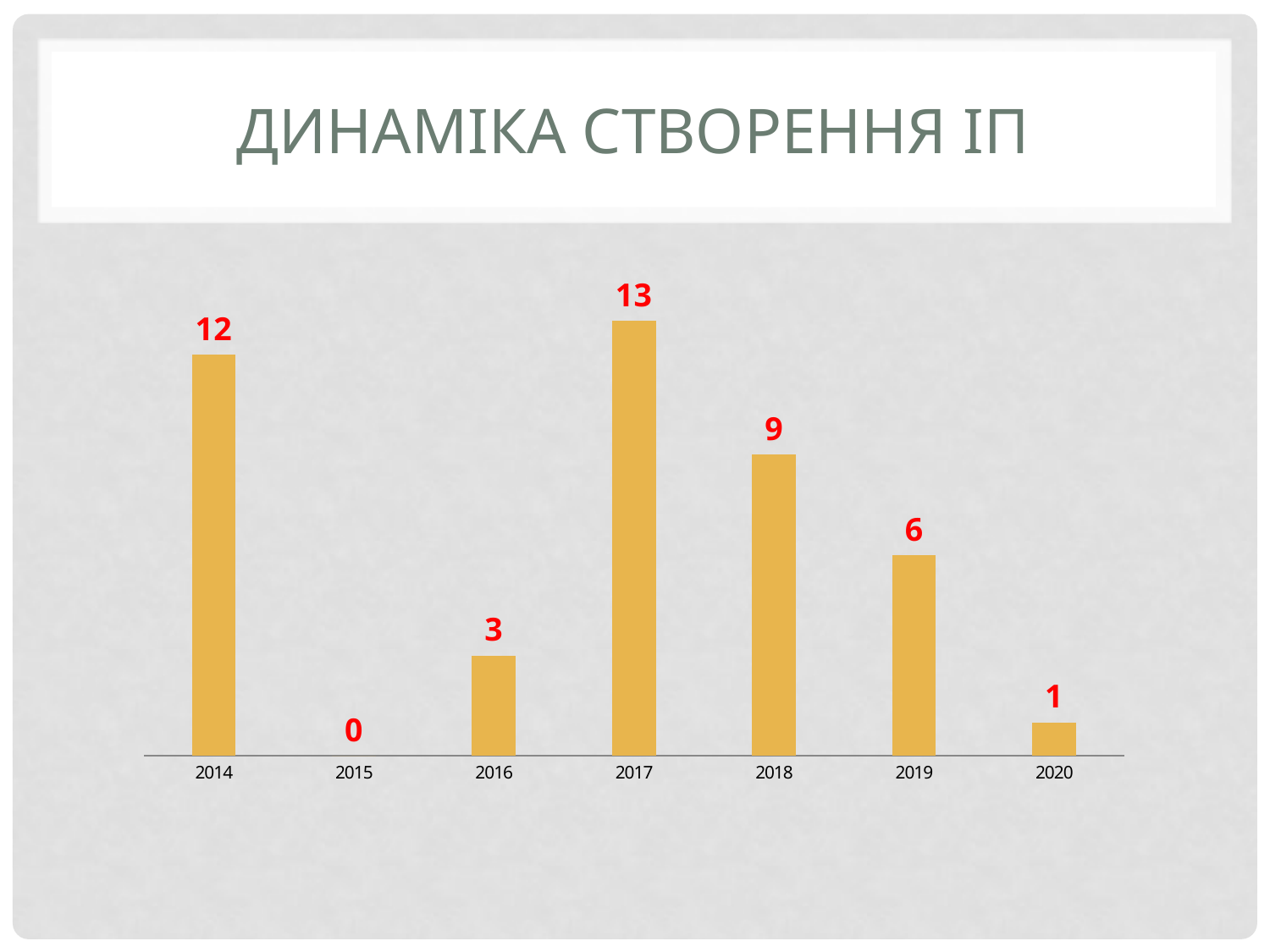
What is the value for 2019? 6 Do the values rise or fall from 2017 to 2020? Fall What kind of chart is shown on the slide? Bar chart What is the value for 2015? 0 What is the difference between the values for 2014 and 2016? 9 How many years are shown on the x axis? 7 What is the value for 2017? 13 What is the difference between the values for 2017 and 2018? 4 Which year has the highest value? 2017 Which is larger, the value for 2014 or the value for 2018? 2014 Which year has the lowest value? 2015 What is the title of the slide? ДИНАМІКА СТВОРЕННЯ ІП